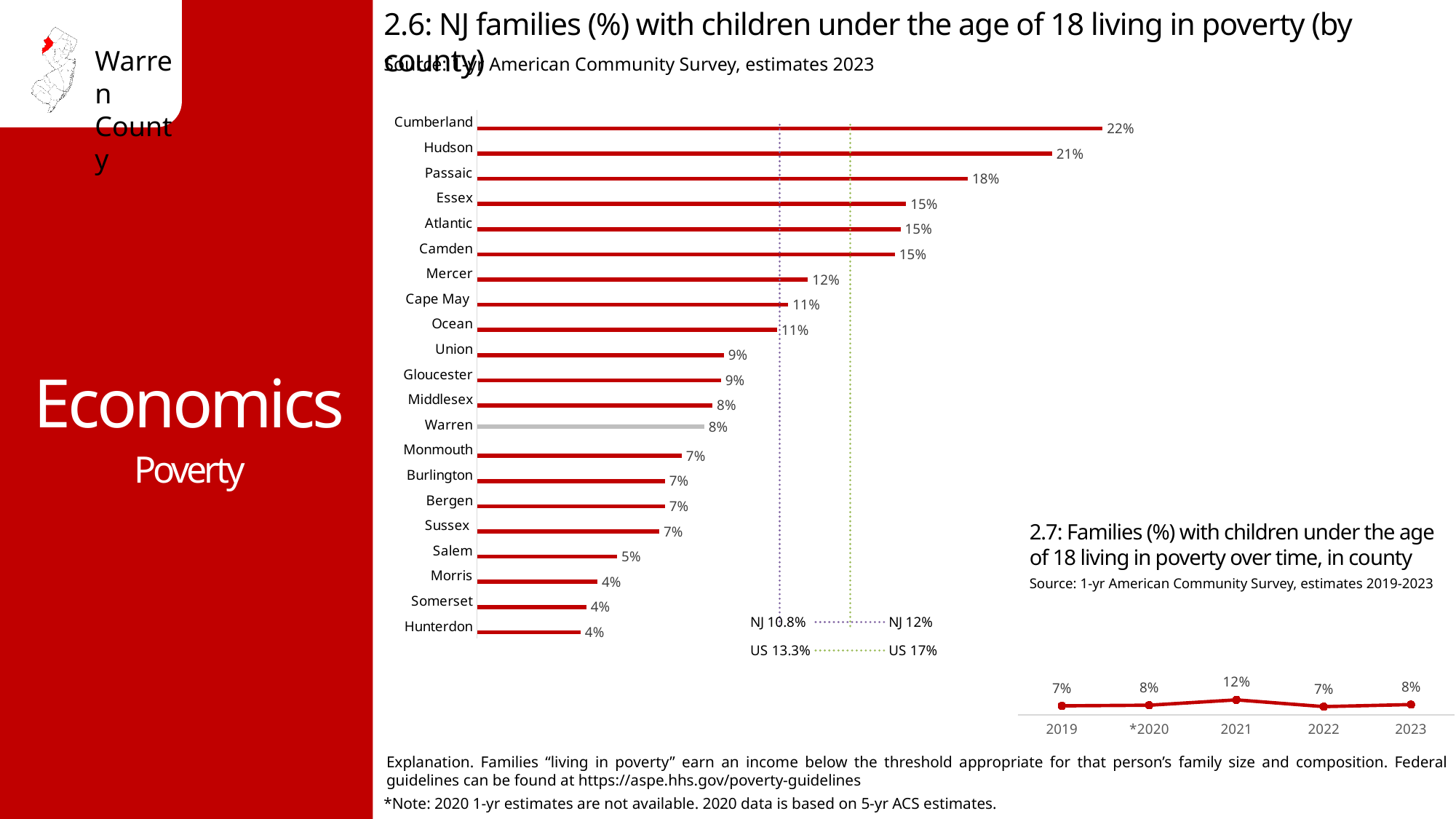
In chart 2.7 (families in poverty over time, in county), what is the value for 2021? 12% What kind of chart is chart 2.6 (by county)? Bar chart In chart 2.6 (by county), what is the difference between Hudson and Passaic? 3% In chart 2.6 (by county), how many counties are plotted? 21 In chart 2.7 (over time, in county), how many years are plotted? 5 In chart 2.7 (over time, in county), what is the difference between 2021 and 2022? 5% In chart 2.6 (by county), which county has the highest value? Cumberland In chart 2.6 (by county), which is larger, the value for Mercer or the value for Salem? Mercer In chart 2.6 (by county), what is the value for Warren? 8% In chart 2.6 (NJ families with children under 18 living in poverty by county), what is the value for Cumberland? 22% In chart 2.7 (over time, in county), which year has the highest value? 2021